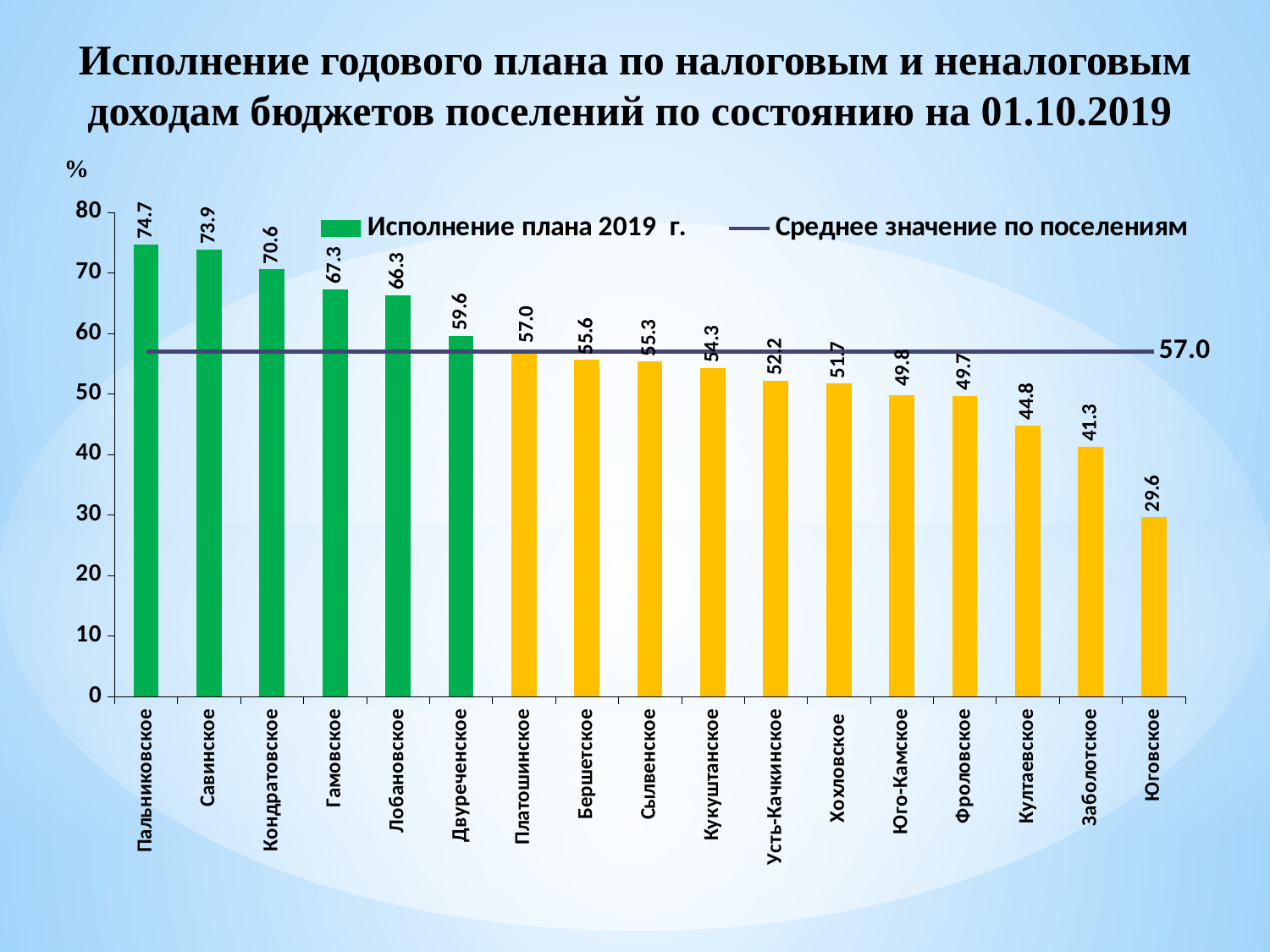
Is the value for Кондратовское greater or less than 60? greater What kind of chart is this? combination bar and line chart How many entries does the legend list? 2 What is the value of the average line (Среднее значение по поселениям)? 57.0 Which settlement has the highest value? Пальниковское What is the value for Заболотское? 41.3 How many settlements are shown on the chart? 17 Which settlement has the lowest value? Юговское Which is larger, the value for Гамовское or the value for Култаевское? Гамовское What is the value for Пальниковское? 74.7 What is the value for Юго-Камское? 49.8 What is the difference between the values for Пальниковское and Юговское? 45.1